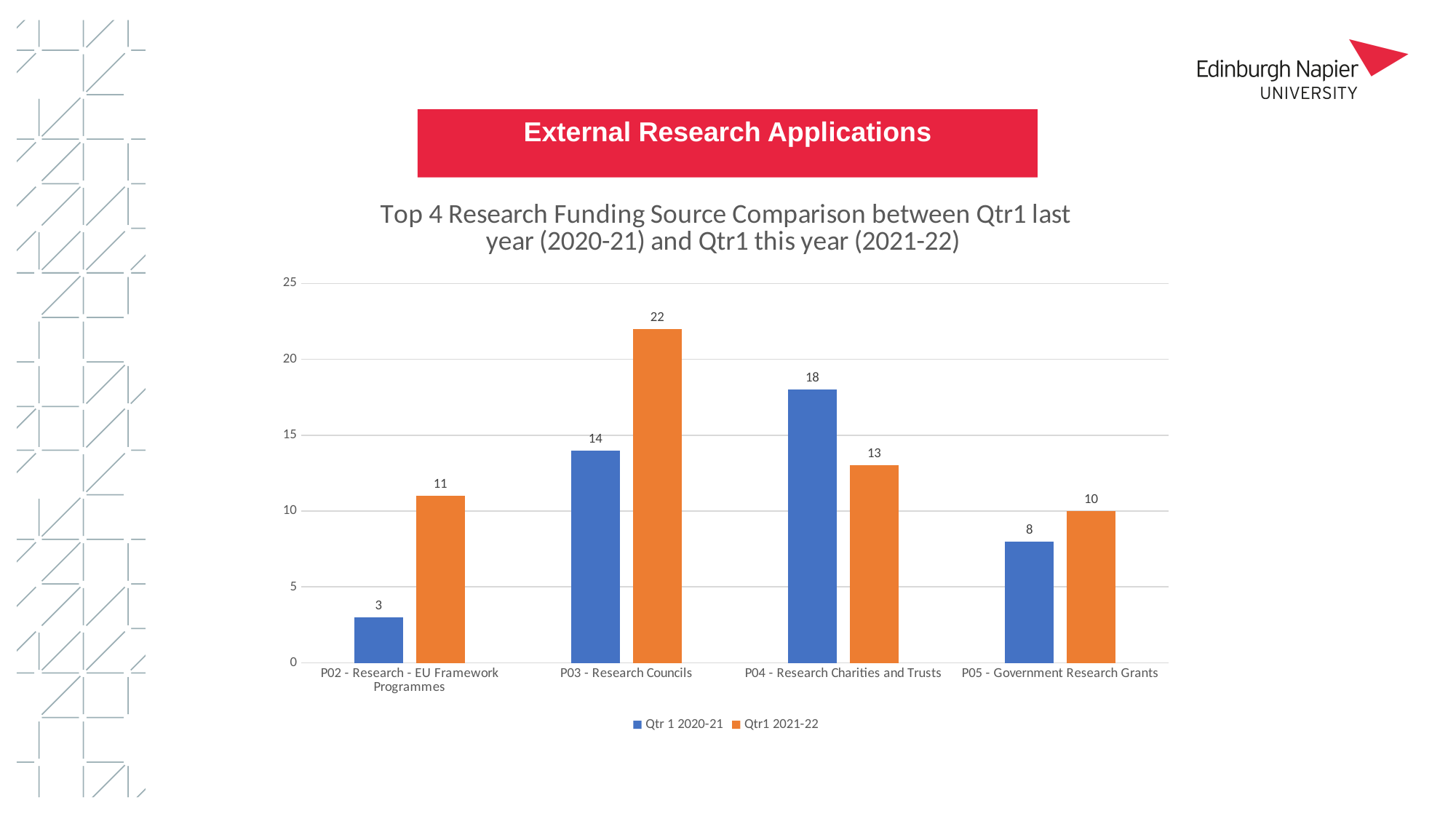
What is the Qtr1 2021-22 value for P05 - Government Research Grants? 10 For P04 - Research Charities and Trusts, which is larger: the Qtr 1 2020-21 value or the Qtr1 2021-22 value? Qtr 1 2020-21 Is the Qtr 1 2020-21 value for P04 - Research Charities and Trusts greater or less than 15? greater How many funding source categories are shown on the x axis? 4 Which category has the lowest Qtr 1 2020-21 value? P02 - Research - EU Framework Programmes Which category has the highest Qtr1 2021-22 value? P03 - Research Councils What colour are the Qtr1 2021-22 bars? Orange What is the Qtr 1 2020-21 value for P03 - Research Councils? 14 What is the difference between the Qtr1 2021-22 and Qtr 1 2020-21 values for P03 - Research Councils? 8 What kind of chart is shown on the slide? Bar chart What is the Qtr1 2021-22 value for P02 - Research - EU Framework Programmes? 11 How many series does the legend list? 2